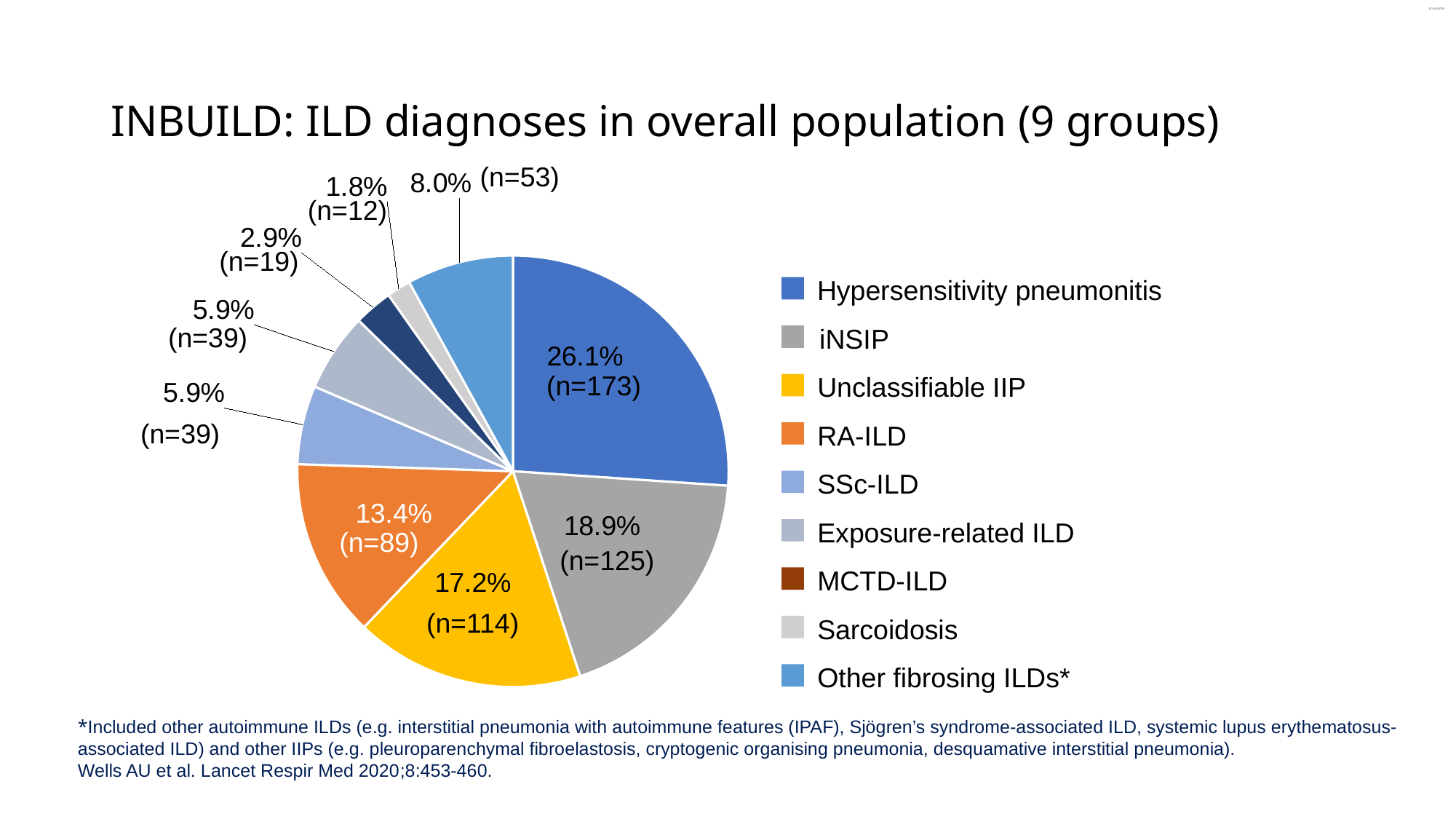
What percentage of the population had unclassifiable IIP? 17.2% What type of chart is shown on the slide? Pie chart What percentage of the population had other fibrosing ILDs? 8.0% Which ILD diagnosis accounts for the smallest share of the overall population? Sarcoidosis How many patients had iNSIP? n=125 What percentage of the overall population had hypersensitivity pneumonitis? 26.1% Which ILD diagnosis accounts for the largest share of the overall population? Hypersensitivity pneumonitis What is the difference in percentage points between hypersensitivity pneumonitis and iNSIP? 7.2 How many ILD diagnosis groups are shown in the pie chart? 9 Which group is larger: RA-ILD or unclassifiable IIP? Unclassifiable IIP What is the percentage for MCTD-ILD? 2.9% How many patients had RA-ILD? n=89